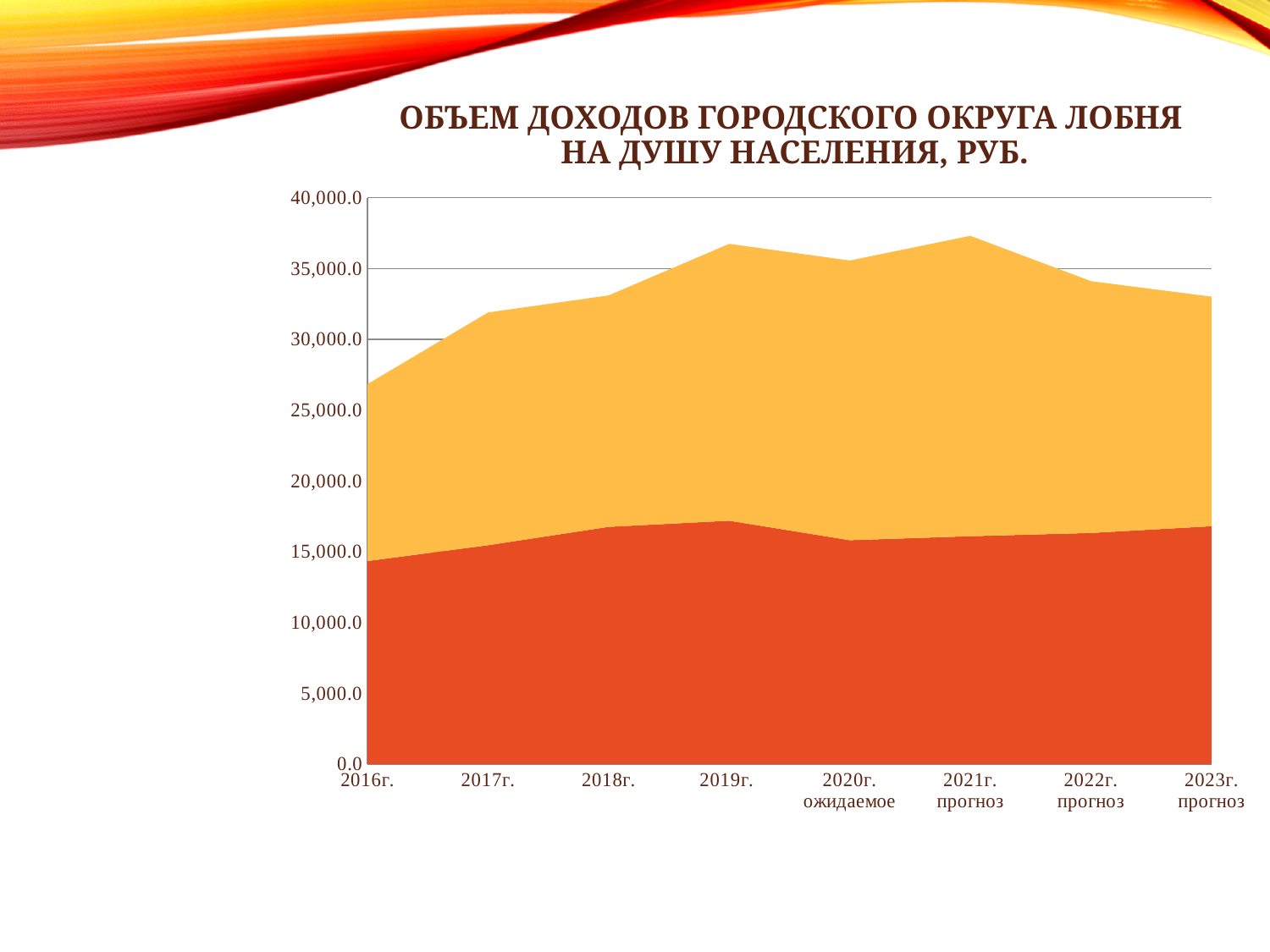
What kind of chart is shown on the slide? Area chart How many coloured stacked areas are plotted in the chart? 2 Is the total stacked value for 2019г. greater or less than 35,000.0? greater What is the title of the chart? ОБЪЕМ ДОХОДОВ ГОРОДСКОГО ОКРУГА ЛОБНЯ НА ДУШУ НАСЕЛЕНИЯ, РУБ. Is the total stacked value for 2016г. greater or less than 30,000.0? less Is the total stacked value for 2023г. прогноз greater or less than 35,000.0? less How many categories are shown along the x axis? 8 Which category has the lowest total stacked value? 2016г. Does the total stacked value rise or fall from 2016г. to 2019г.? rise